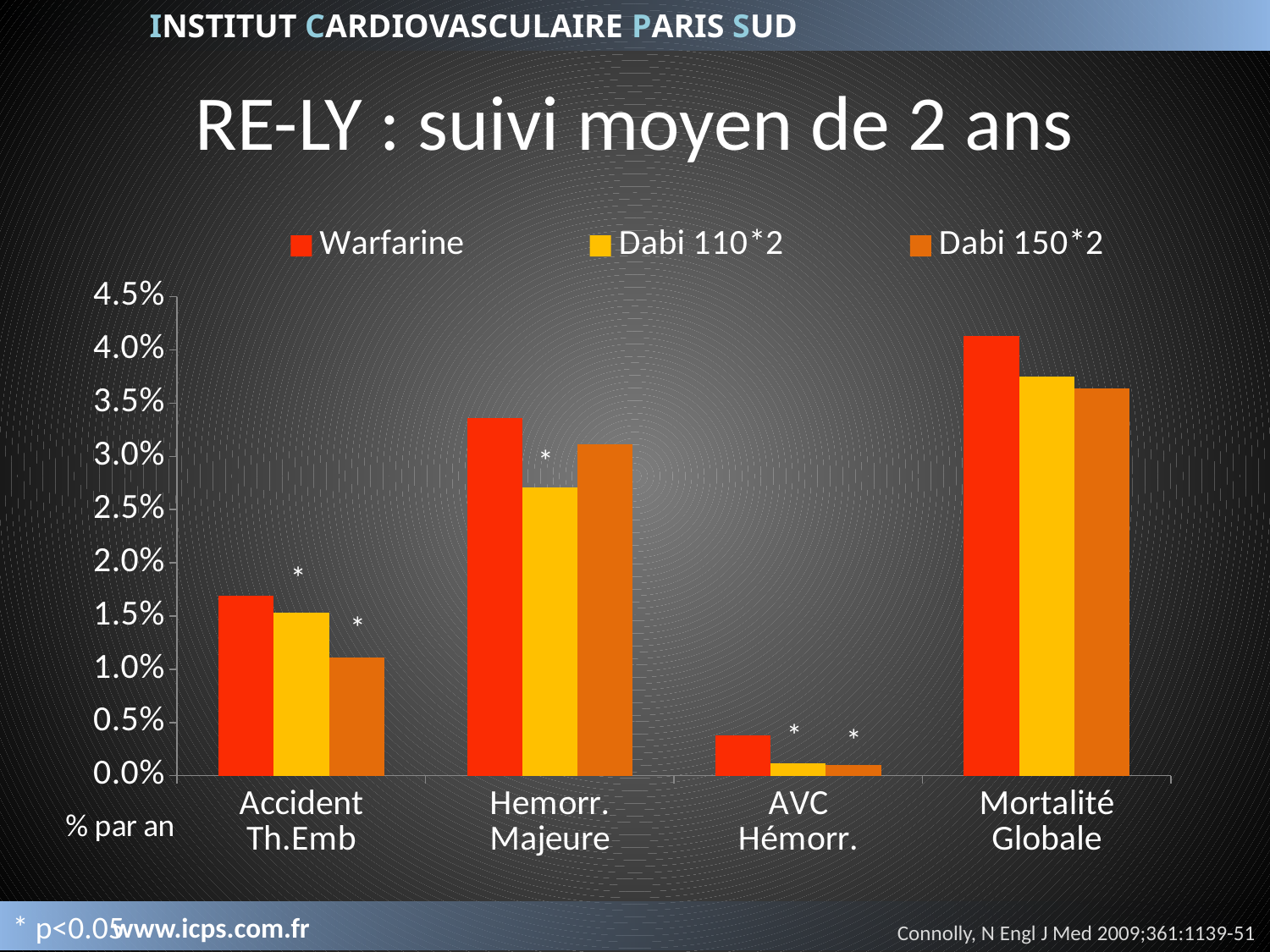
For Hemorr. Majeure, which is larger: Dabi 110*2 or Dabi 150*2? Dabi 150*2 Is the Warfarine value for AVC Hémorr. greater or less than 0.5%? less Is the Dabi 110*2 value for Hemorr. Majeure greater or less than 3.0%? less Which category has the highest Warfarine value? Mortalité Globale What are the three series named in the legend? Warfarine, Dabi 110*2, Dabi 150*2 Is the Dabi 110*2 value for Mortalité Globale greater or less than 3.5%? greater How many series does the legend list? 3 Which category has the lowest Warfarine value? AVC Hémorr. How many categories are shown on the x axis? 4 What kind of chart is shown on the slide? bar chart For Accident Th.Emb, which is larger: Warfarine or Dabi 150*2? Warfarine